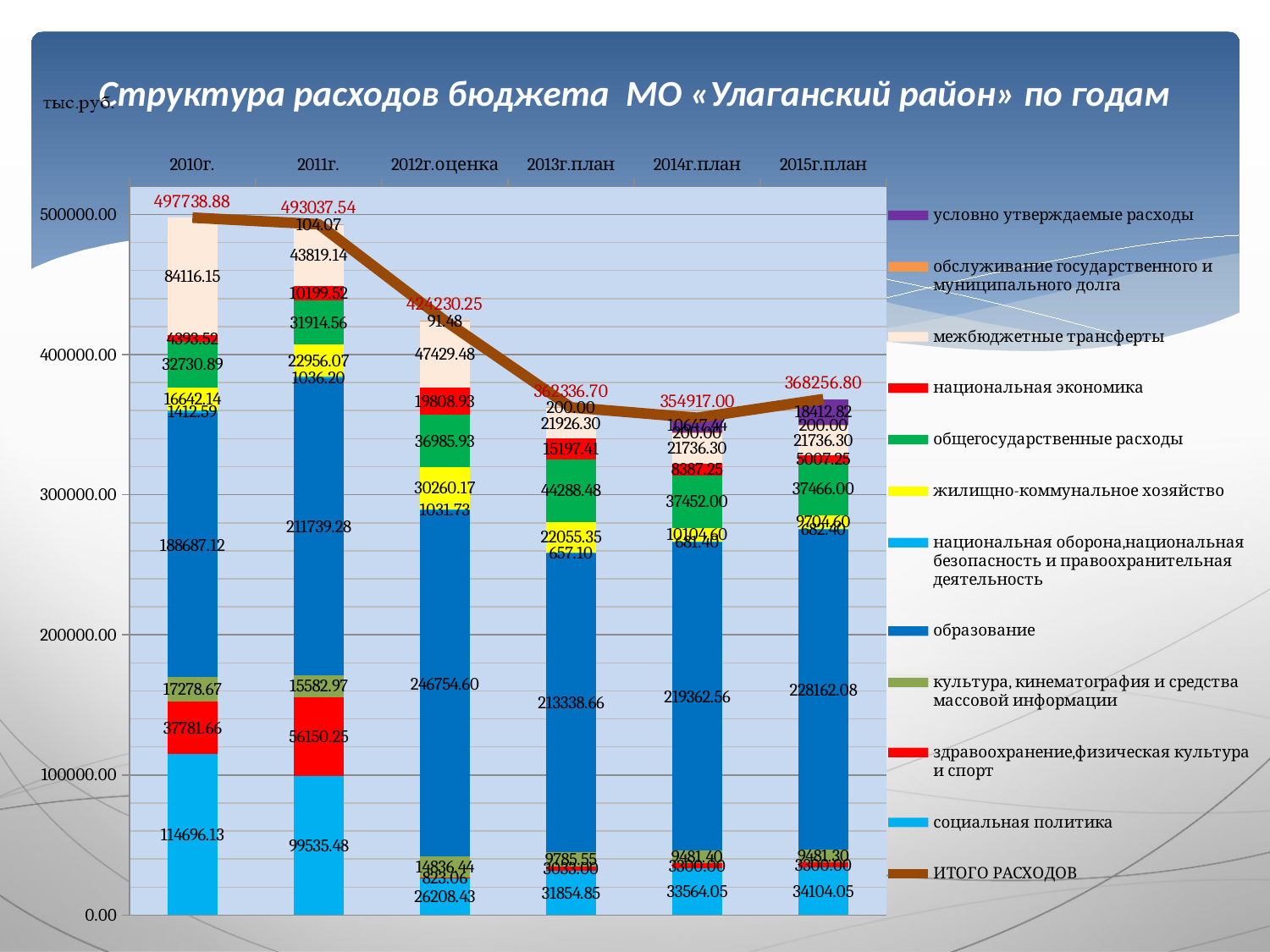
Which year has the highest total expenditure (ИТОГО РАСХОДОВ)? 2010г. What is the difference between the total expenditure for 2010г. and 2011г.? 4701.34 What kind of chart is this? Stacked bar chart with a line What is the total expenditure (ИТОГО РАСХОДОВ) for 2010г.? 497738.88 Which is larger, the образование value for 2015г.план or for 2014г.план? 2015г.план What is the value of образование for 2012г.оценка? 246754.60 What is the value of социальная политика for 2010г.? 114696.13 How many years are shown on the x axis? 6 What is the value of межбюджетные трансферты for 2011г.? 43819.14 Which year has the lowest total expenditure (ИТОГО РАСХОДОВ)? 2014г.план How many entries does the legend list? 12 Is the total expenditure for 2013г.план greater or less than 400000.00? less